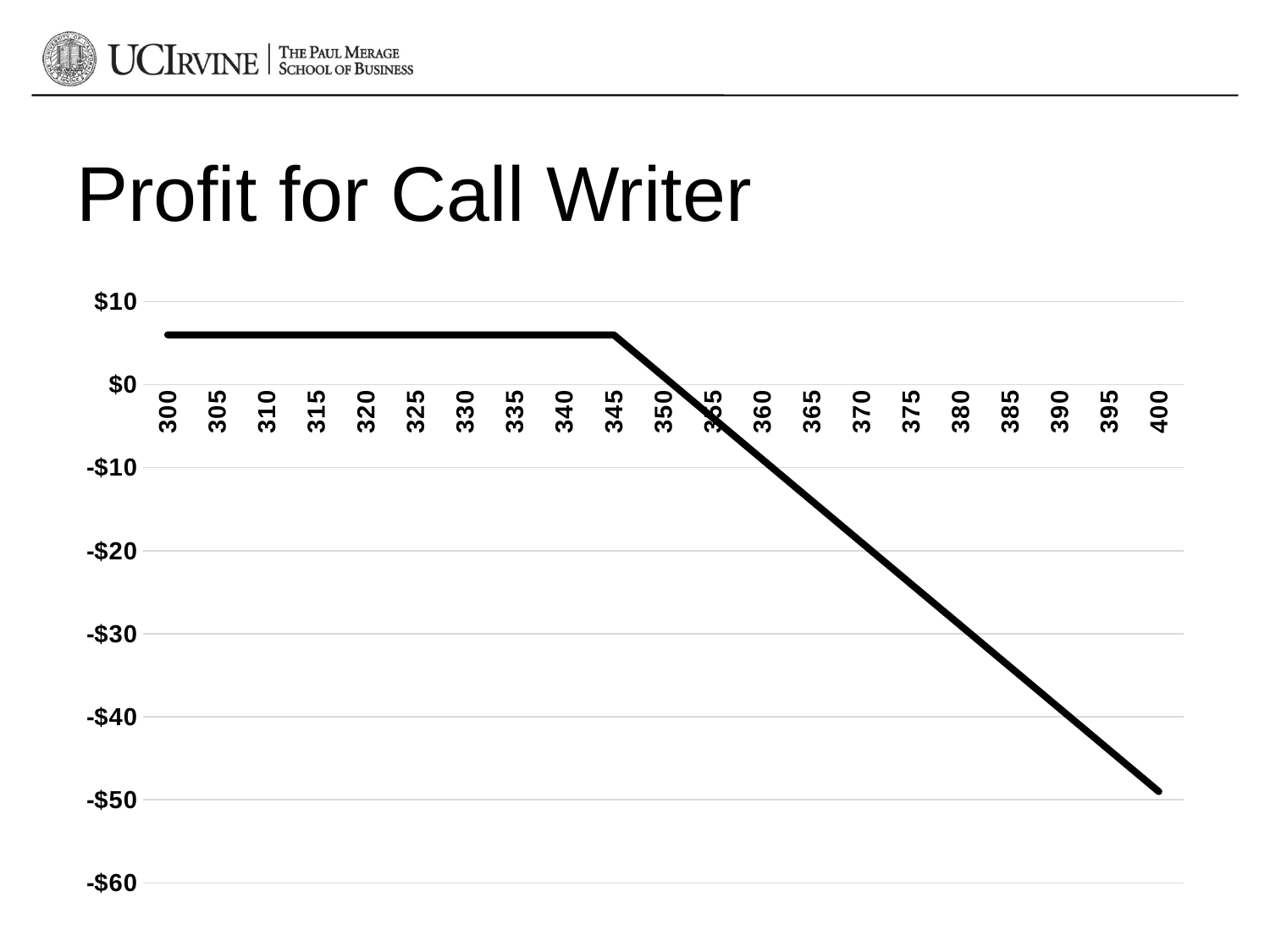
Is the profit at 340 greater or less than $10? less Is the profit at 380 greater or less than -$20? less At which x-axis value is the profit lowest? 400 What kind of chart is shown on the slide? line chart How many points are labelled along the x axis of the chart? 21 Is the profit at 370 greater or less than -$10? less What is the title of the chart? Profit for Call Writer What is the lowest value shown on the y axis? -$60 Does the profit rise or fall as the x-axis value increases from 345 to 400? fall Which has the larger profit, 320 or 380? 320